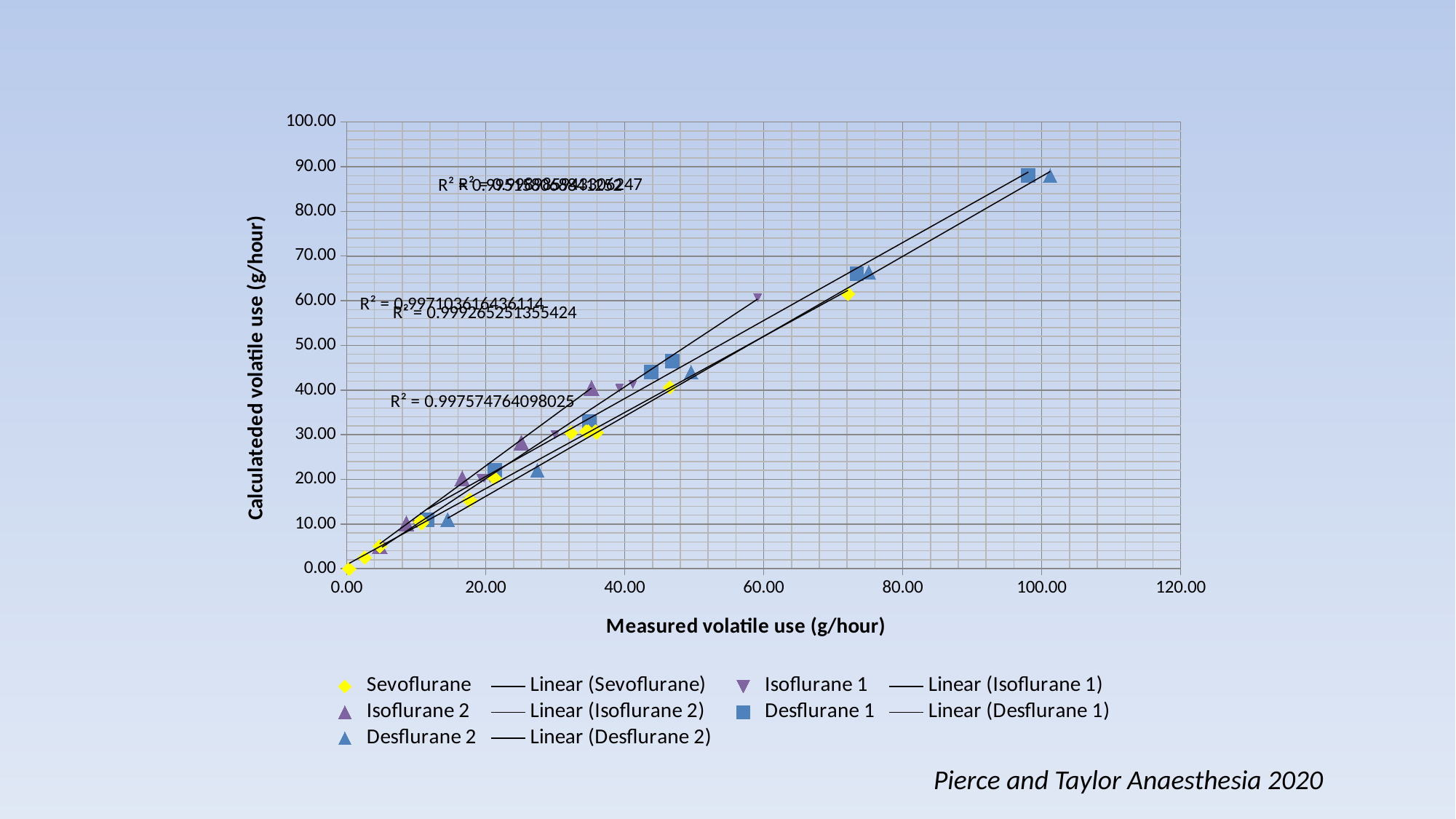
How many data series (excluding the linear trendlines) are plotted? 5 Is the calculated volatile use for the Desflurane 1 point near 100 g/hour measured use greater or less than 80? greater How many entries does the legend list? 10 Is the calculated volatile use for the Sevoflurane point near 72 g/hour measured use greater or less than 50? greater Is the calculated volatile use for the Isoflurane 1 point near 59 g/hour measured use greater or less than 50? greater What is the title of the x axis? Measured volatile use (g/hour) What is the highest tick value shown on the x axis? 120.00 What is the title of the y axis? Calculateded volatile use (g/hour) Do the calculated volatile use values rise or fall as measured volatile use increases? Rise What is the highest tick value shown on the y axis? 100.00 What kind of chart is shown on the slide? Scatter chart